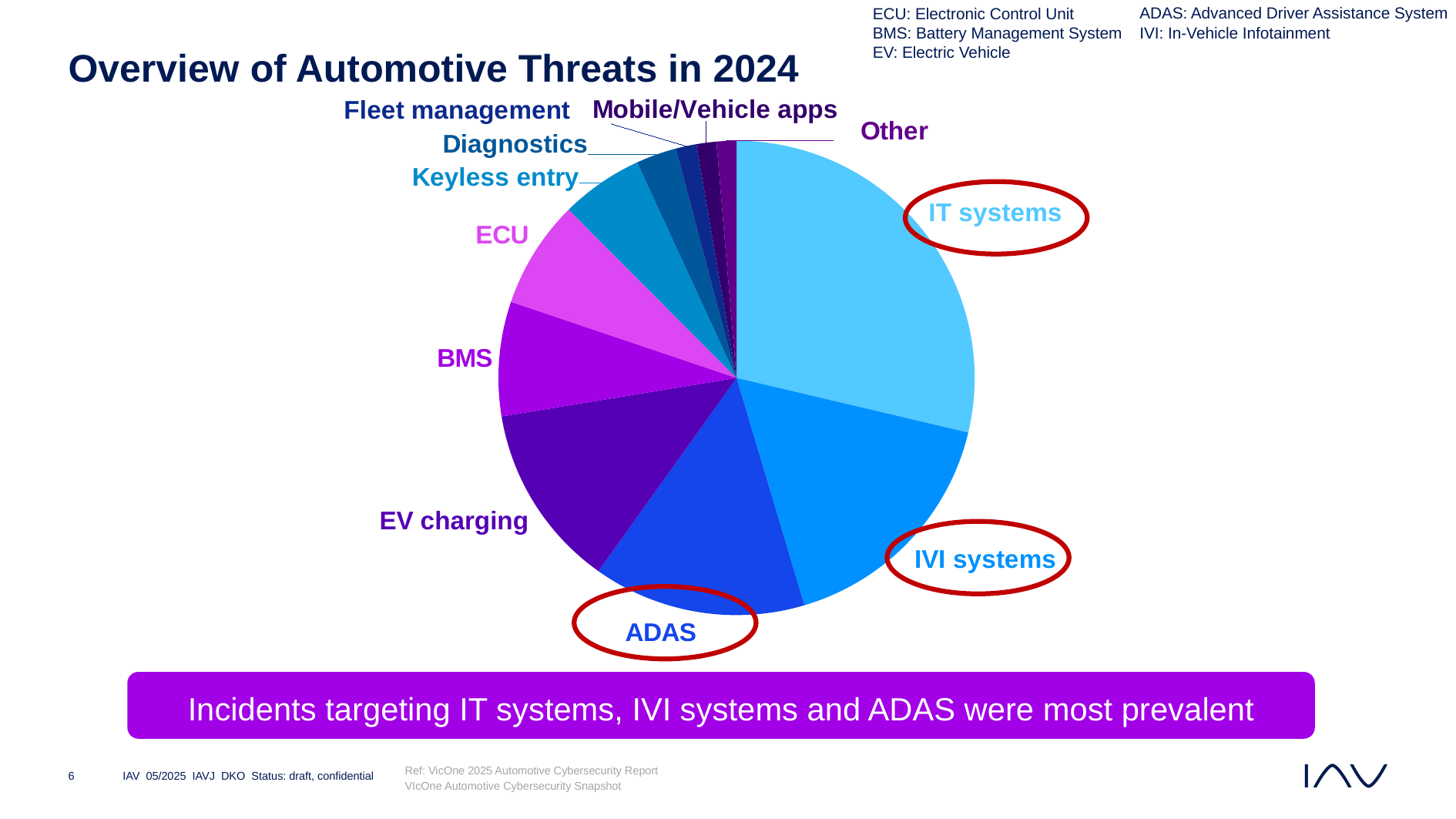
What kind of chart is shown on the slide? Pie chart Which slice is larger, IVI systems or BMS? IVI systems Which slice is larger, ECU or Diagnostics? ECU How many categories (slices) does the pie chart show? 11 Which slice is larger, EV charging or Keyless entry? EV charging What is the title of the slide containing the pie chart? Overview of Automotive Threats in 2024 Which three category labels on the pie chart are circled in red? IT systems, IVI systems and ADAS Which category has the largest slice of the pie chart? IT systems